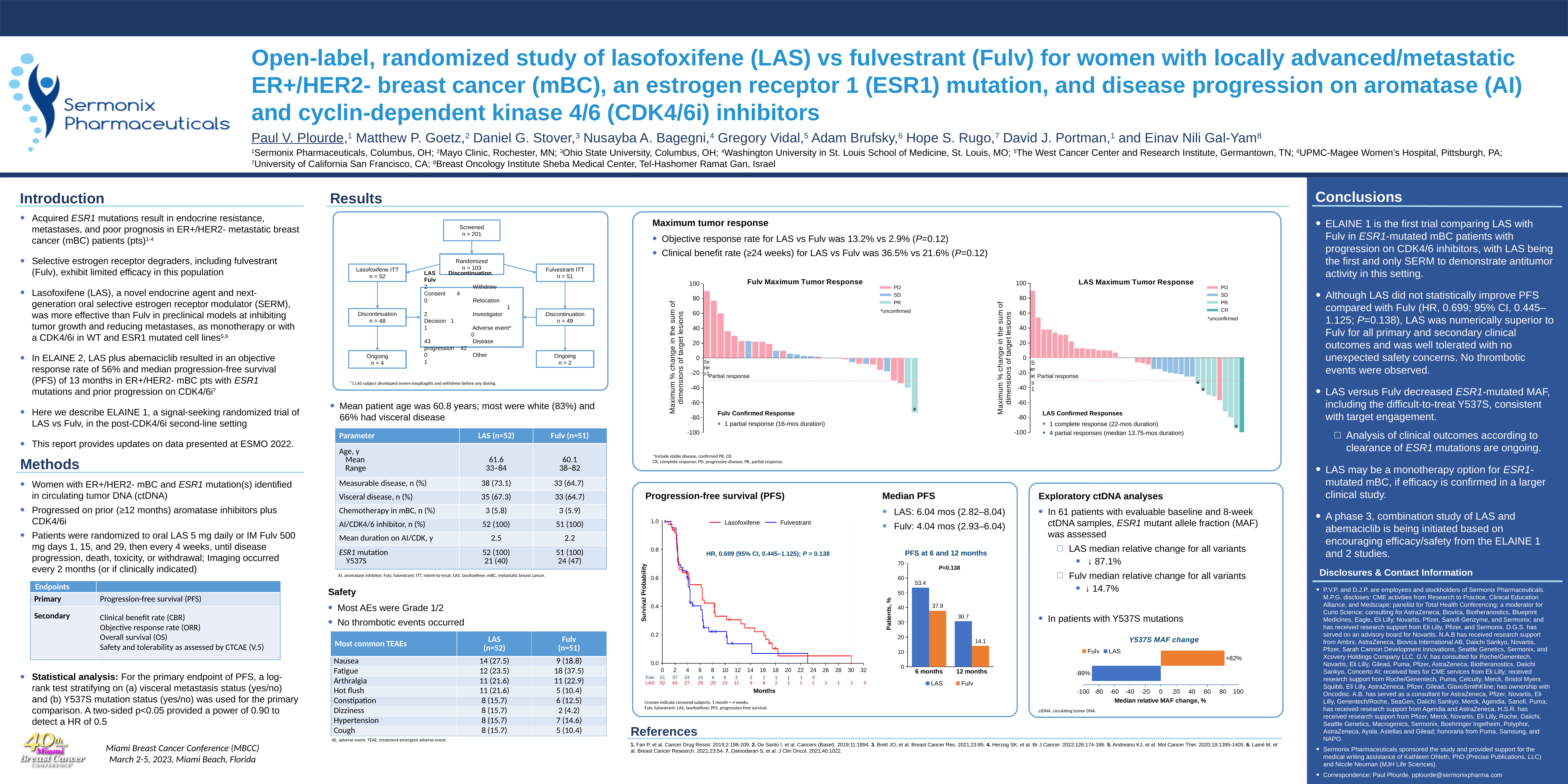
In the 'PFS at 6 and 12 months' chart, how many series does the legend list? 2 What kind of chart is the 'Y537S MAF change' chart? Bar chart In the 'Y537S MAF change' chart, what is the median relative MAF change for LAS? -89% In the 'PFS at 6 and 12 months' chart, what is the value for Fulv at 6 months? 37.9 In the 'LAS Maximum Tumor Response' chart, how many categories does the legend list? 4 In the progression-free survival chart, which colour is the Lasofoxifene curve? Red In the 'PFS at 6 and 12 months' chart, which bar is the highest? LAS at 6 months In the 'PFS at 6 and 12 months' chart, what is the value for Fulv at 12 months? 14.1 In the 'Y537S MAF change' chart, what is the median relative MAF change for Fulv? +82% In the 'PFS at 6 and 12 months' chart, what is the value for LAS at 6 months? 53.4 In the 'PFS at 6 and 12 months' chart, which is larger at 12 months, LAS or Fulv? LAS In the 'PFS at 6 and 12 months' chart, what is the difference between LAS and Fulv at 6 months? 15.5